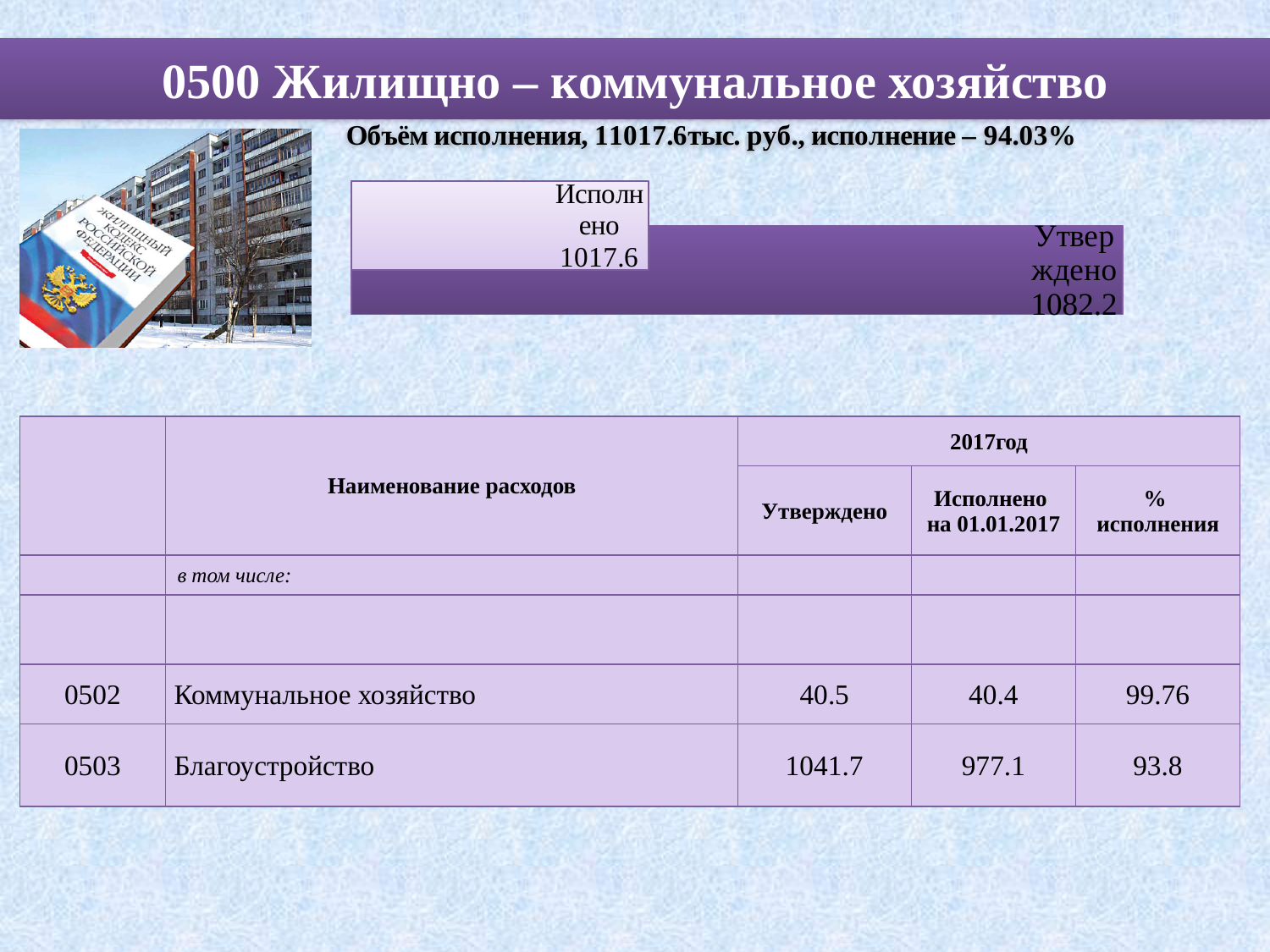
How many bars does the chart show? 2 Which bar in the chart has the higher value? Утверждено Which bar in the chart is drawn in the darker purple colour? Утверждено What is the difference between the Утверждено and Исполнено values in the chart? 64.6 Which bar in the chart has the lower value? Исполнено Is the Исполнено value larger or smaller than the Утверждено value in the chart? smaller What is the value of the Утверждено bar in the chart? 1082.2 What kind of chart is shown on the slide? bar chart What is the value of the Исполнено bar in the chart? 1017.6